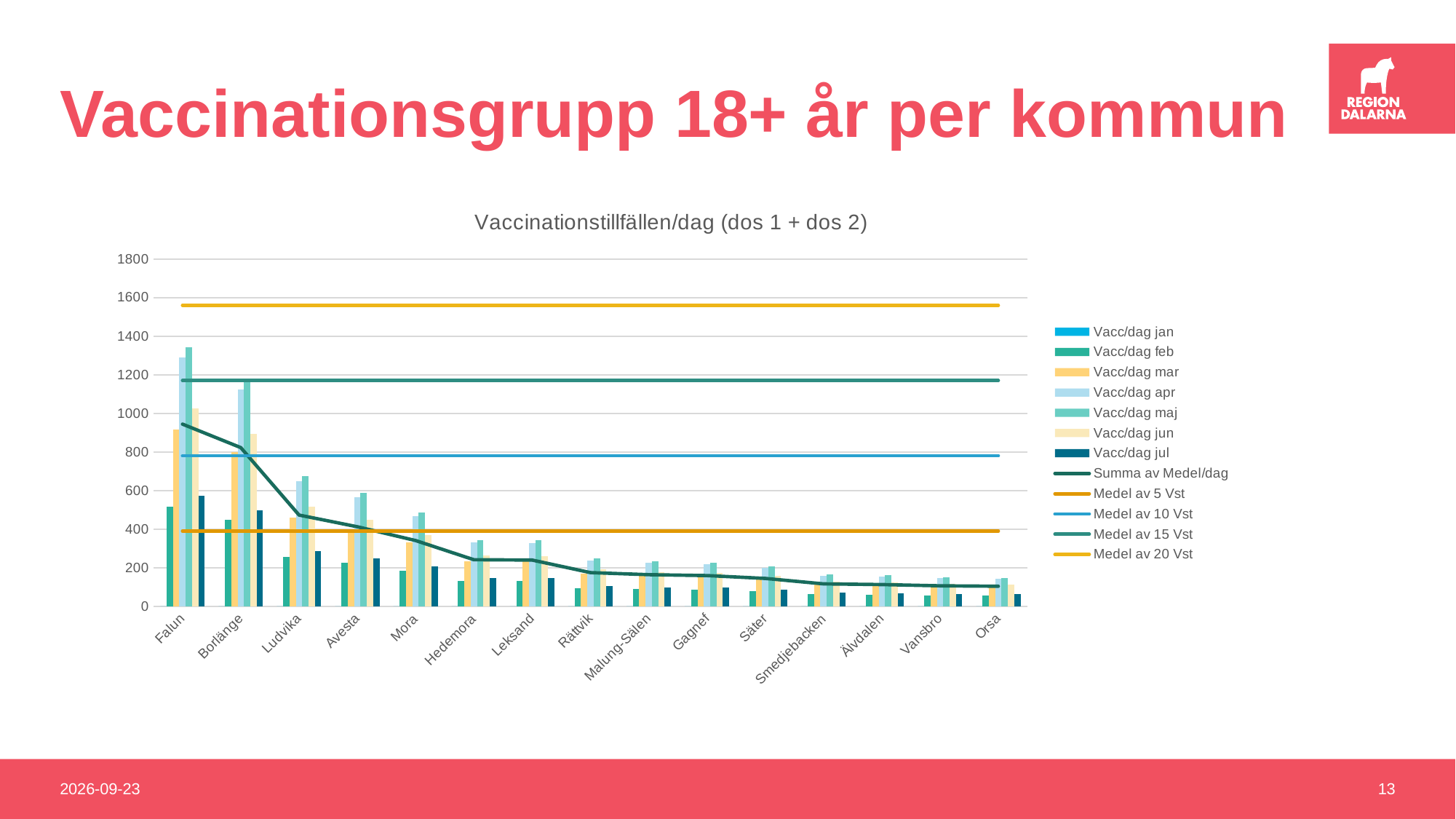
Does the Summa av Medel/dag line rise or fall from Falun to Orsa? It falls Is the Medel av 20 Vst line greater or less than 1400? greater What kind of chart is shown on the slide? A bar chart combined with line series What is the title of the chart? Vaccinationstillfällen/dag (dos 1 + dos 2) Is the Vacc/dag apr value for Borlänge greater or less than 1000? greater Is the Vacc/dag maj value for Falun greater or less than 1200? greater Which municipality has the highest Vacc/dag maj bar? Falun How many series does the chart legend list? 12 How many municipalities are shown on the x axis of the chart? 15 Which is larger, the Vacc/dag jul value for Falun or for Borlänge? Falun